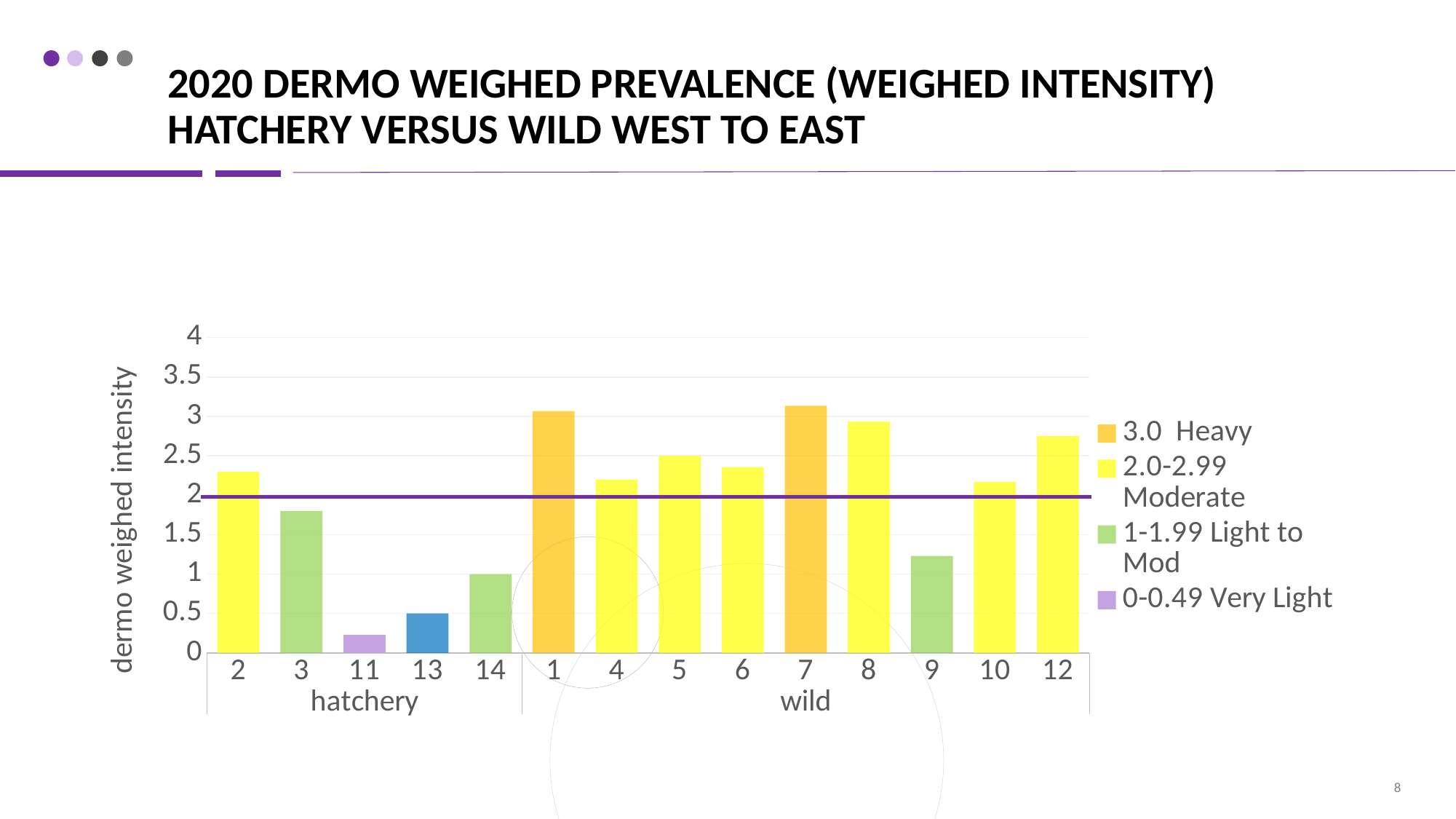
What kind of chart is shown on the slide? bar chart What is the dermo weighed intensity for hatchery site 14? 1 Which has the larger value, wild site 1 or wild site 4? 1 What is the dermo weighed intensity for hatchery site 13? 0.5 Is the value for wild site 8 greater or less than 3? less How many bars are plotted in the chart? 14 Which legend category is shown in orange? 3.0 Heavy What is the label on the vertical axis? dermo weighed intensity Is the value for wild site 12 greater or less than 2.5? greater Which site has the lowest dermo weighed intensity? 11 How many entries does the legend list? 4 Is the value for hatchery site 3 greater or less than 2? less